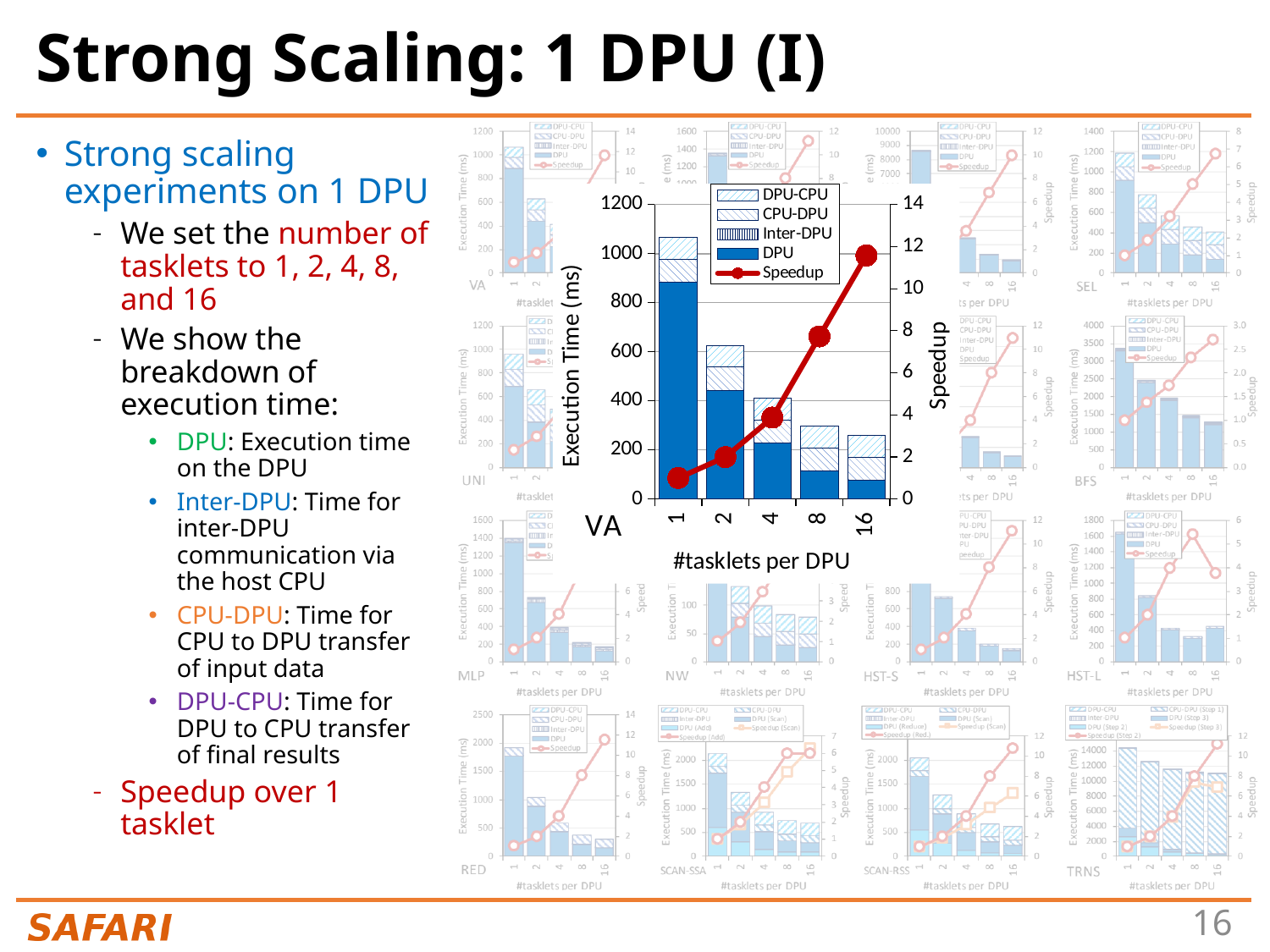
On the enlarged VA chart, how many entries does the legend list? 5 On the enlarged VA chart, does the Speedup line rise or fall as the number of tasklets increases? rise On the enlarged VA chart, which number of tasklets has the shortest execution-time bar? 16 On the enlarged VA chart, is the total execution time for 1 tasklet greater or less than 1000 ms? greater What kind of chart is the enlarged VA chart (the bars)? bar chart What is the x-axis title of the enlarged VA chart? #tasklets per DPU On the enlarged VA chart, is the total execution time for 16 tasklets greater or less than 400 ms? less On the enlarged VA chart, which number of tasklets has the tallest execution-time bar? 1 On the enlarged VA chart in the center of the slide, how many tasklet counts are shown on the x axis? 5 On the enlarged VA chart, which has the larger total execution time: 2 tasklets or 8 tasklets? 2 tasklets On the enlarged VA chart, does the execution time rise or fall as the number of tasklets increases? fall On the enlarged VA chart, is the Speedup for 16 tasklets greater or less than 10? greater